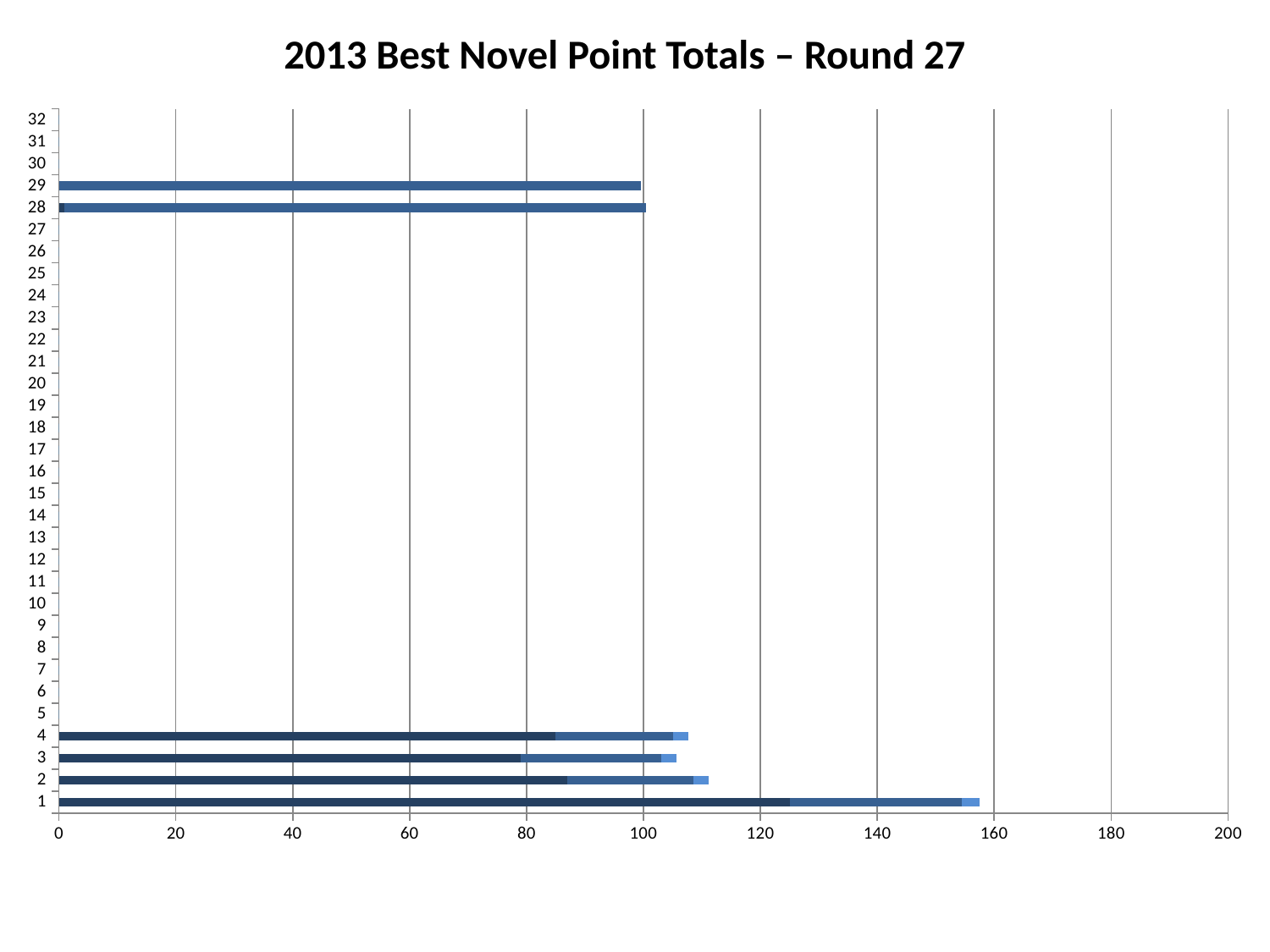
What is the title of the chart? 2013 Best Novel Point Totals – Round 27 Is the value for category 4 greater or less than 120? less Is the value for category 29 greater or less than 80? greater What kind of chart is shown on the slide? bar chart Is the value for category 1 greater or less than 140? greater Which has a larger point total, category 1 or category 2? 1 How many categories have a bar plotted on the chart? 6 Which has a larger point total, category 2 or category 3? 2 Which category has the highest point total? 1